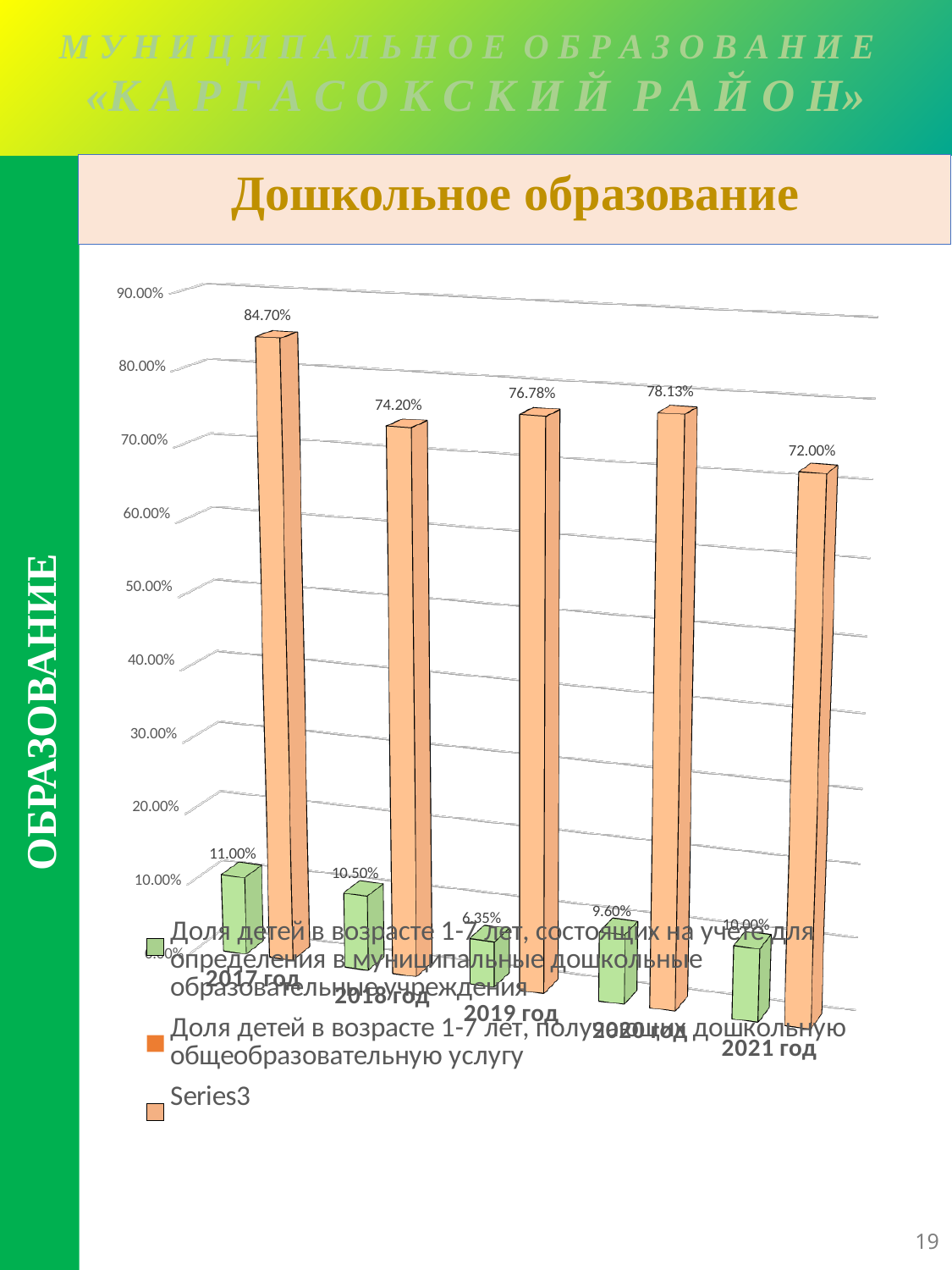
How many entries does the chart legend list? 3 What is the title shown above the chart? Дошкольное образование What is the value of the orange series for 2021 год? 72.00% What is the value of the orange series (share of children aged 1-7 receiving a preschool educational service) for 2017 год? 84.70% What is the difference between the orange series values for 2017 год and 2021 год? 12.70% Which is larger for the orange series: the value for 2019 год or the value for 2020 год? 2020 год How many years (categories) are shown on the x axis of the chart? 5 What is the value of the green series (share of children aged 1-7 on the waiting list for municipal preschool institutions) for 2019 год? 6.35% In which year is the orange series (share of children receiving a preschool service) highest? 2017 год In which year is the green series (share of children on the waiting list) lowest? 2019 год What type of chart is shown on the slide? bar chart Is the value of the orange series for 2018 год greater or less than 80.00%? less